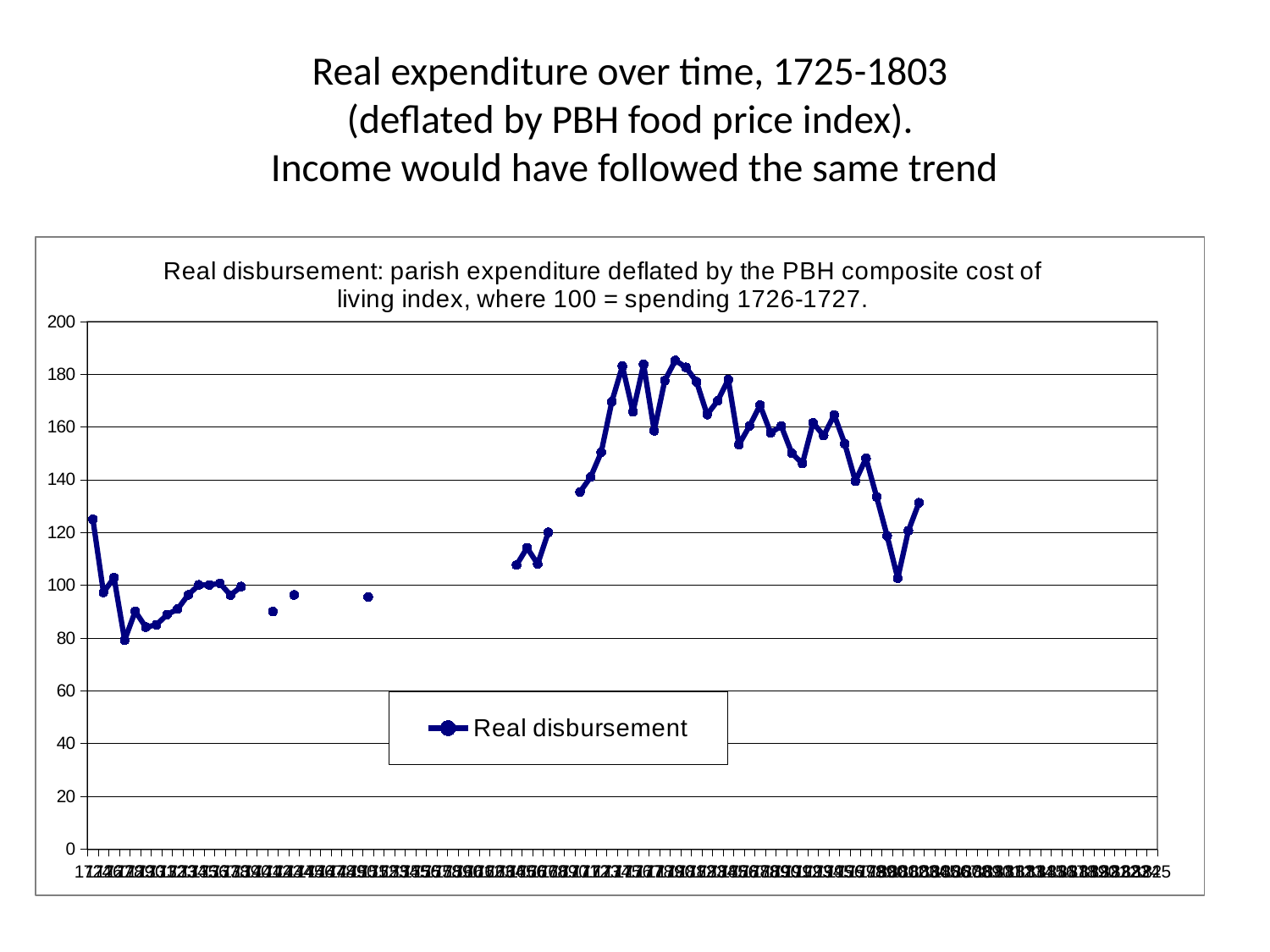
Do the values rise or fall between the first plotted point and the second plotted point? fall Is the highest value reached by the Real disbursement series greater or less than 180? greater What is the name of the series shown in the legend? Real disbursement Is the peak of the series located in the left half or the right half of the chart? right half Is the lowest value reached by the Real disbursement series greater or less than 100? less What kind of chart is shown on the slide? line chart What is the title printed inside the chart area? Real disbursement: parish expenditure deflated by the PBH composite cost of living index, where 100 = spending 1726-1727. Is the last plotted point of the Real disbursement series greater or less than 120? greater How many series does the legend list? 1